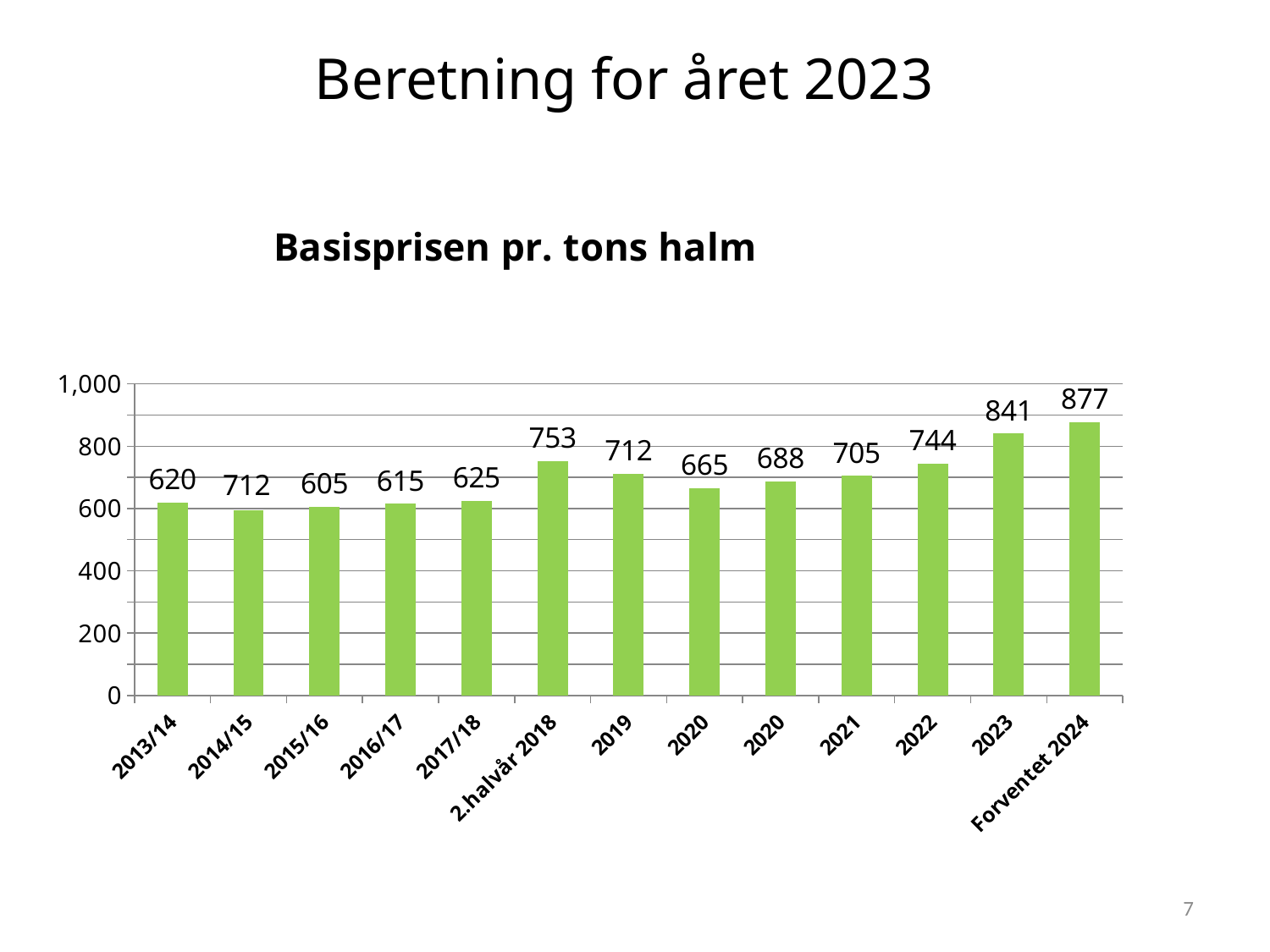
What is the value for Forventet 2024? 877 What is the value for 2013/14 in the chart? 620 What is the difference between the values for Forventet 2024 and 2023? 36 What is the value for 2.halvår 2018? 753 How many bars are shown in the chart? 13 Is the value for 2016/17 greater or less than 800? less What is the difference between the values for 2023 and 2022? 97 Which category has the highest value in the chart? Forventet 2024 What is the value for 2023 in the chart? 841 What kind of chart is shown on the slide? bar chart Which is larger, the value for 2022 or the value for 2019? 2022 What is the title of the chart? Basisprisen pr. tons halm